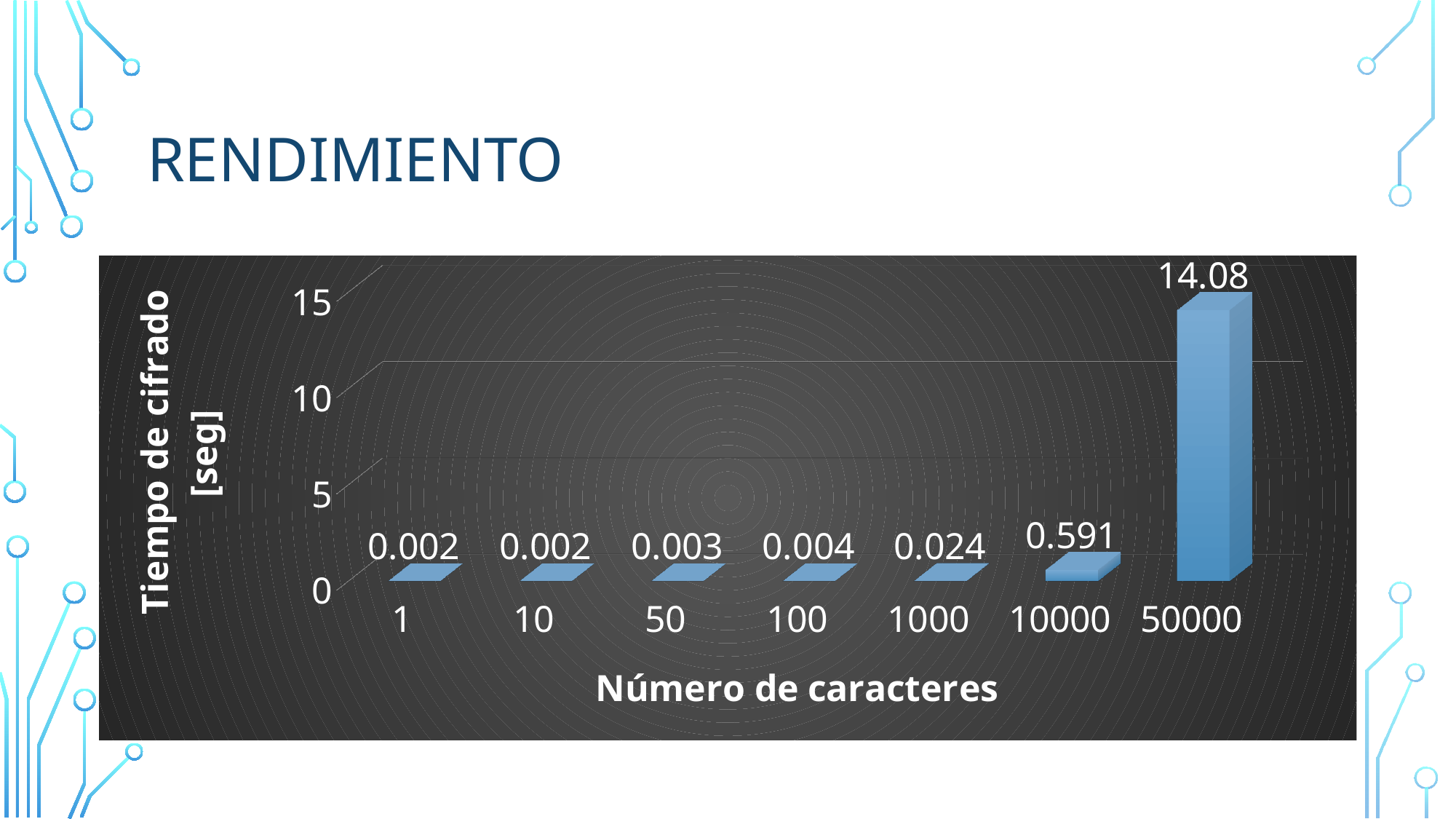
How many categories (numbers of characters) are shown on the x axis? 7 What is the difference in encryption time between 50000 and 10000 characters? 13.489 What kind of chart is shown on the slide? Bar chart What is the encryption time for 10000 characters? 0.591 What is the encryption time (Tiempo de cifrado) for 50000 characters? 14.08 What is the encryption time for 1000 characters? 0.024 Which number of characters has the highest encryption time? 50000 What is the encryption time for 100 characters? 0.004 What is the label of the x axis? Número de caracteres Is the encryption time for 50000 characters greater or less than 10? greater What is the difference in encryption time between 1000 and 100 characters? 0.02 Which has a larger encryption time, 10000 characters or 1000 characters? 10000 characters